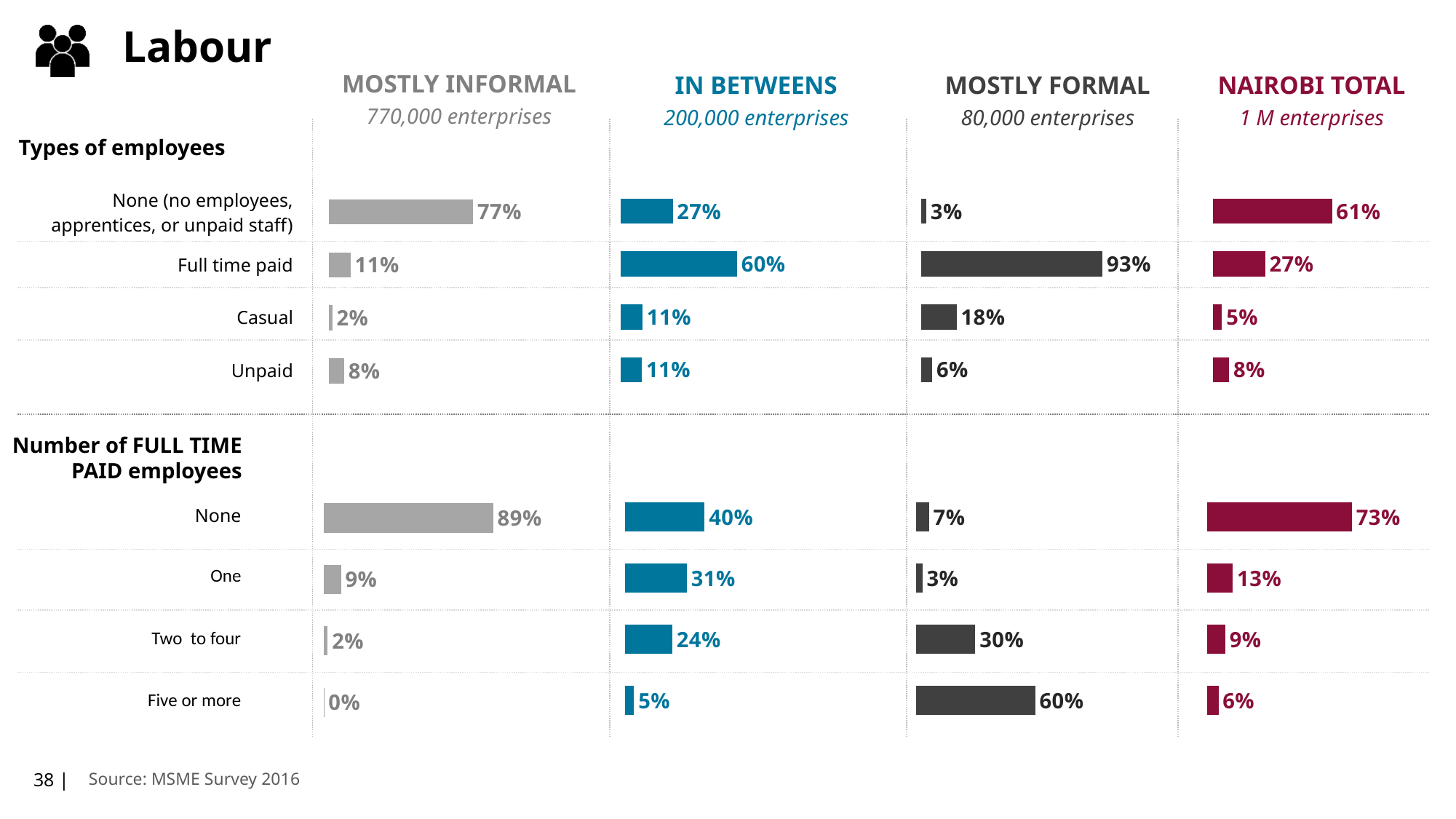
In the Number of full time paid employees section, what is the value for Two to four in the Mostly Formal column? 30% In the Types of employees section, what is the value for Full time paid in the Mostly Formal column? 93% In the Number of full time paid employees section, which category has the highest value in the Nairobi Total column? None In the Number of full time paid employees section, which is larger for the In Betweens column: None or One? None In the Number of full time paid employees section, what is the value for Five or more in the In Betweens column? 5% How many categories are shown in the Types of employees section? 4 How many enterprises does the In Betweens column represent? 200,000 enterprises In the Types of employees section, what is the difference between the Full time paid values for Mostly Formal and Mostly Informal? 82 percentage points What kind of chart is used to show the values on this slide? Bar chart How many categories are shown in the Number of full time paid employees section? 4 In the Types of employees section, what is the value for None (no employees, apprentices, or unpaid staff) in the Mostly Informal column? 77% In the Types of employees section, which category has the lowest value in the Mostly Formal column? None (no employees, apprentices, or unpaid staff)